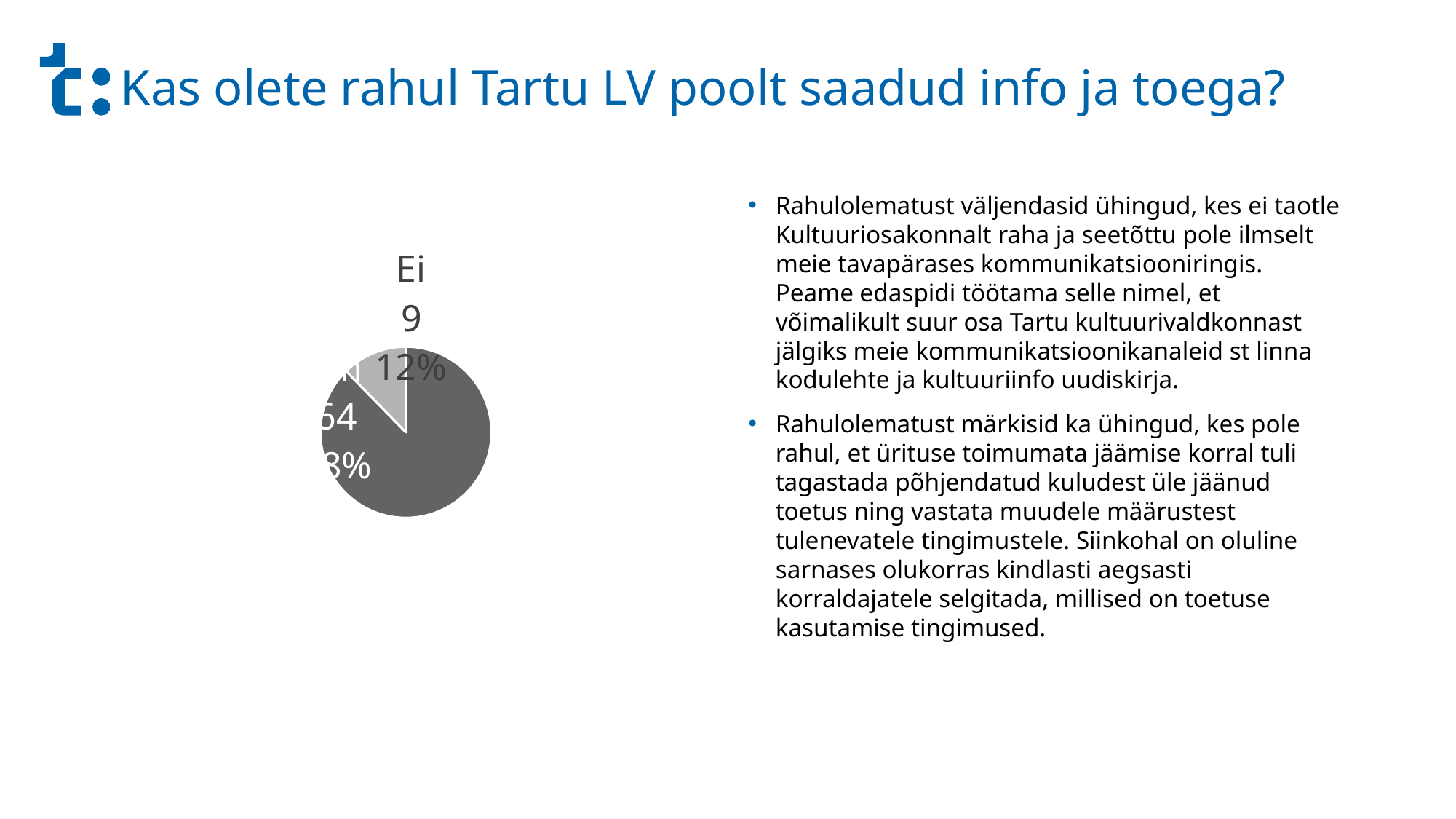
What kind of chart is shown on the slide? pie chart Does the "Ei" slice make up more or less than half of the pie? less Is the "Ei" slice larger or smaller than the dark grey slice? smaller What colour is the "Ei" slice of the pie chart? light grey What percentage share of the pie does the "Ei" slice have? 12% How many slices does the pie chart have? 2 Which slice of the pie chart is the smallest? Ei What is the value shown for the "Ei" slice of the pie chart? 9